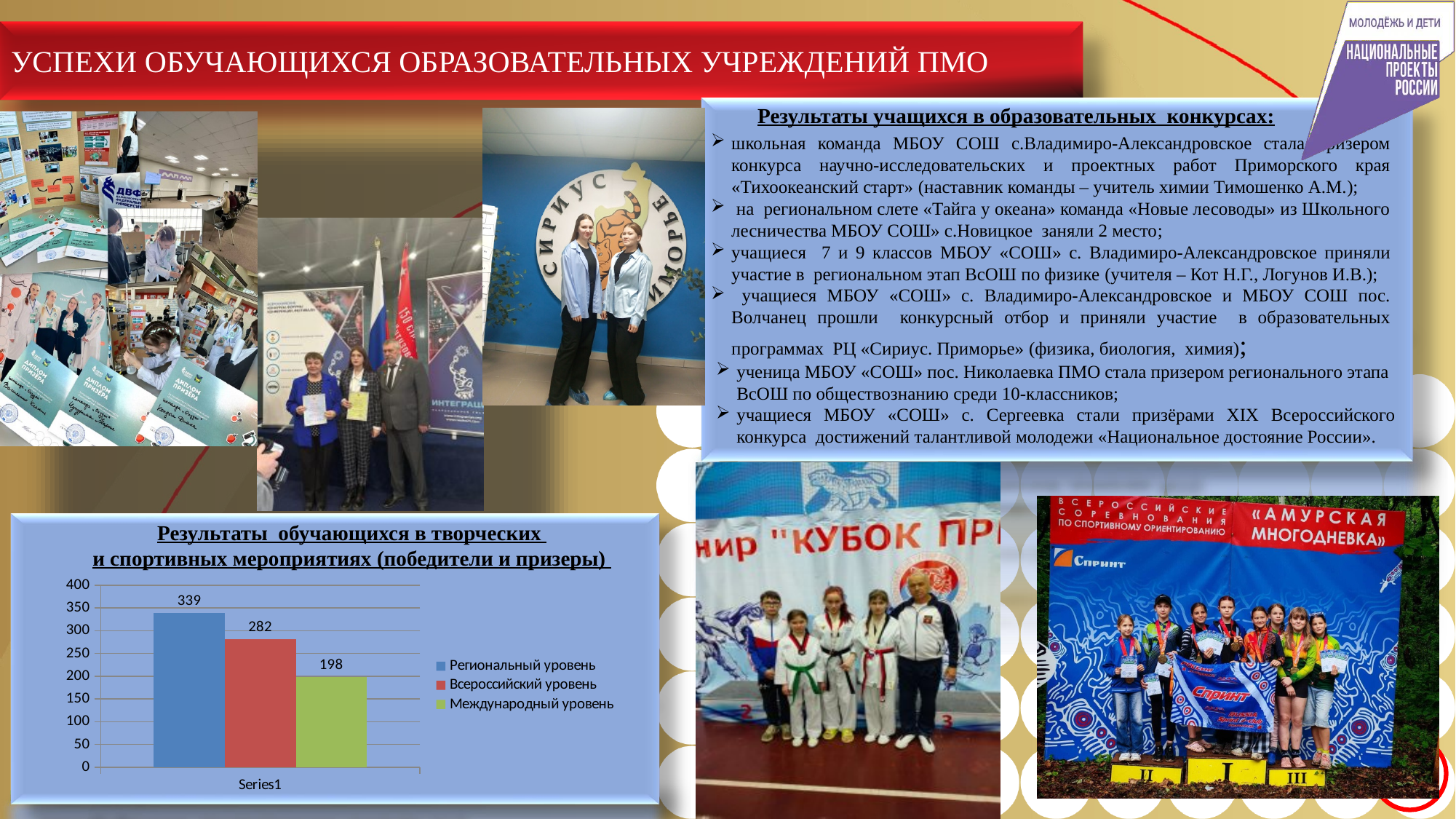
What is the difference between the values for Всероссийский уровень and Международный уровень? 84 What is the value for Региональный уровень? 339 Which is larger, the value for Всероссийский уровень or Международный уровень? Всероссийский уровень Is the value for Международный уровень greater or less than 250? less How many series does the legend list? 3 What type of chart is shown on the slide? bar chart Which series has the highest value? Региональный уровень What is the value for Международный уровень? 198 What colour is the bar for Международный уровень? green What is the value for Всероссийский уровень? 282 What is the difference between the values for Региональный уровень and Всероссийский уровень? 57 Which series has the lowest value? Международный уровень